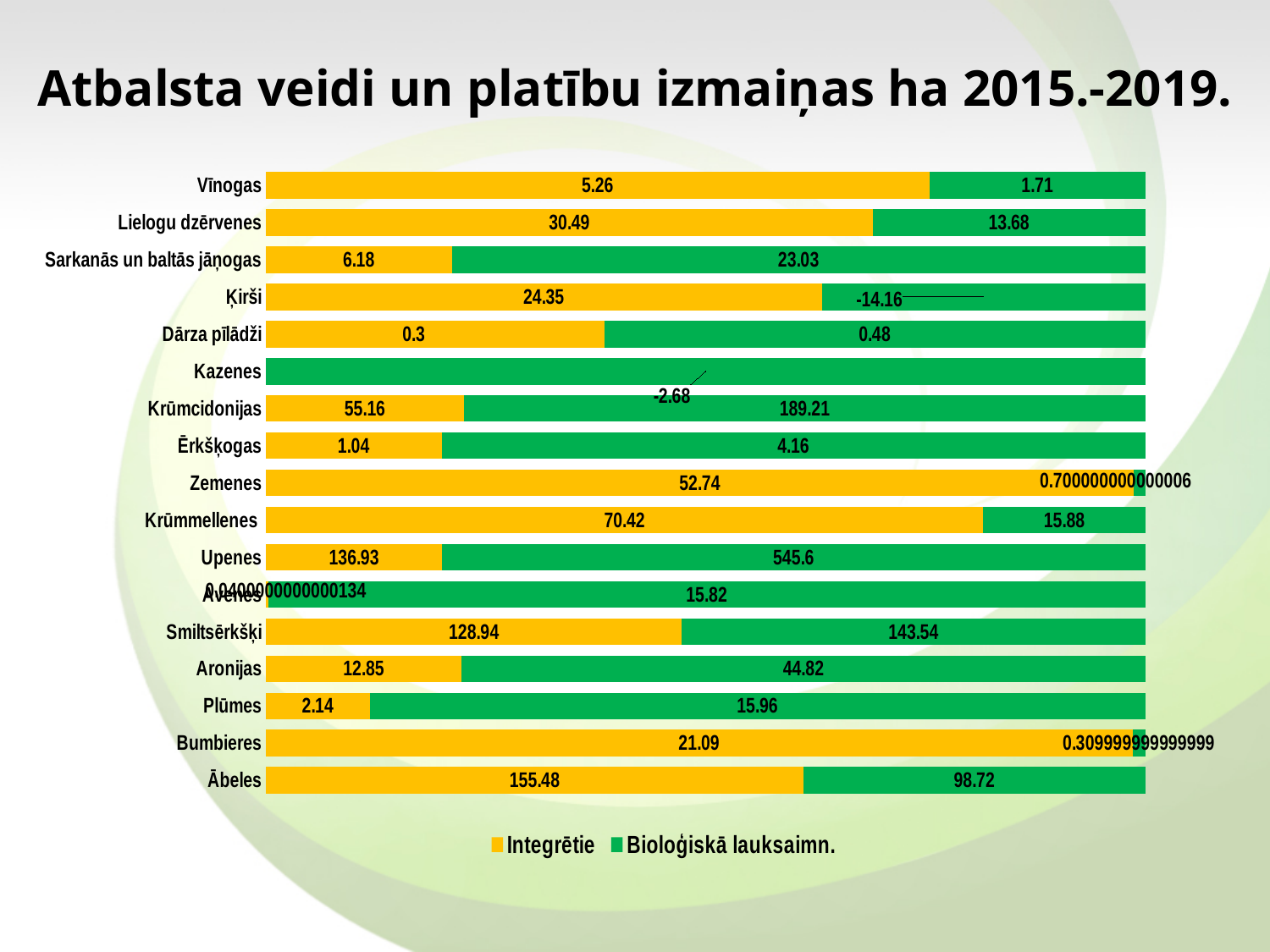
How many series does the legend list? 2 What is the Integrētie value for Ābeles? 155.48 What is the difference between the Integrētie and Bioloģiskā lauksaimn. values for Ābeles? 56.76 Which category has the lowest Bioloģiskā lauksaimn. value? Ķirši What is the Bioloģiskā lauksaimn. value for Upenes? 545.6 What kind of chart is shown on the slide? Stacked bar chart What is the Bioloģiskā lauksaimn. value for Ķirši? -14.16 What is the Integrētie value for Krūmmellenes? 70.42 Which category has the highest Integrētie value? Ābeles For Smiltsērkšķi, which is larger: the Integrētie value or the Bioloģiskā lauksaimn. value? Bioloģiskā lauksaimn. How many categories are shown on the chart? 17 Which category has the highest Bioloģiskā lauksaimn. value? Upenes